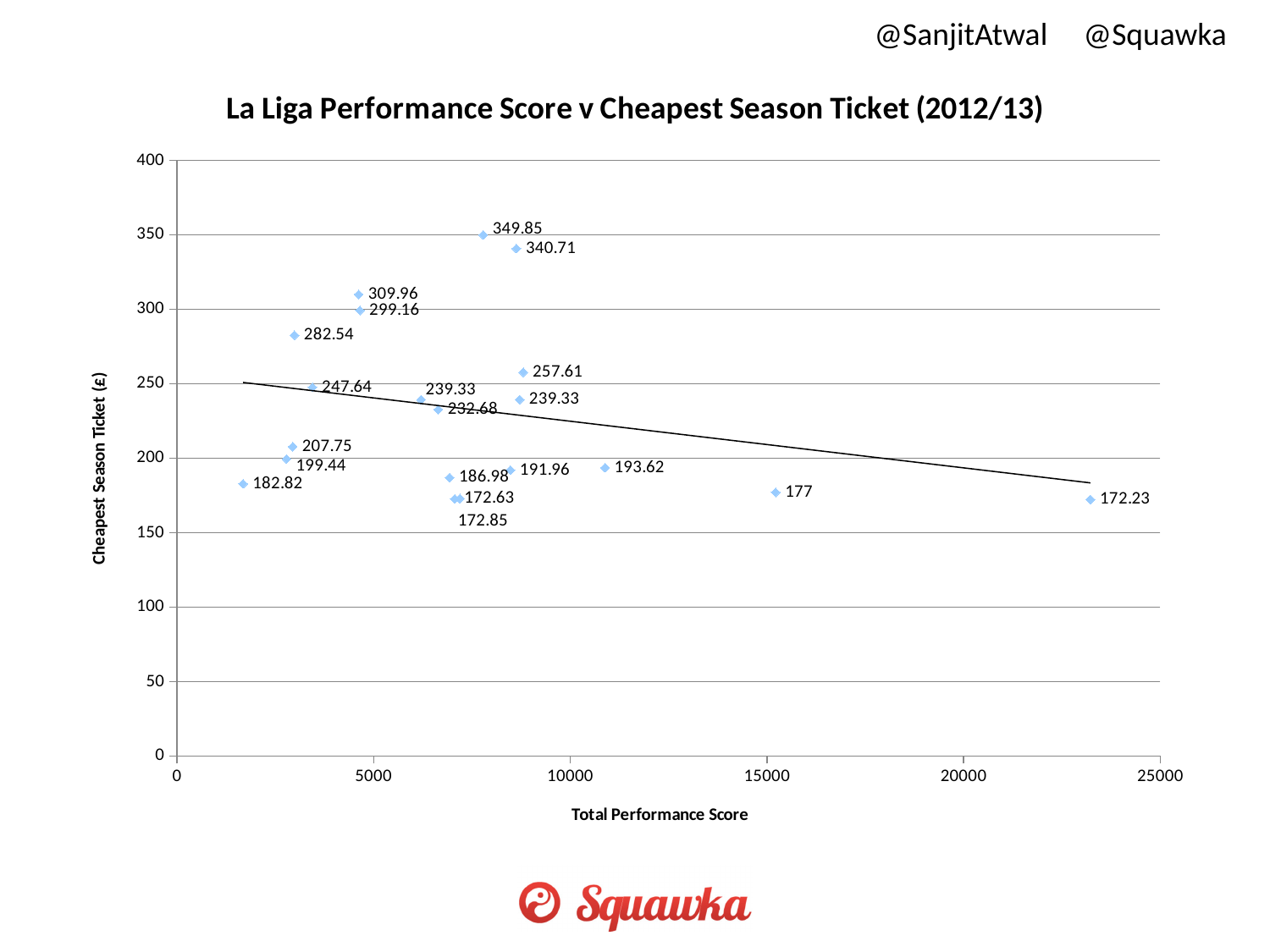
Does the trend line show the cheapest season ticket rising or falling as Total Performance Score increases? Falling What is the highest cheapest season ticket value labelled on the chart? 349.85 What kind of chart is shown on the slide? Scatter chart What is the lowest cheapest season ticket value labelled on the chart? 172.23 What is the label of the vertical axis? Cheapest Season Ticket (£) What is the cheapest season ticket value for the point plotted at a Total Performance Score of roughly 15000? 177 What is the cheapest season ticket value for the point with the highest Total Performance Score? 172.23 How many data points are plotted on the chart? 20 What is the difference between the highest and lowest labelled cheapest season ticket values? 177.62 How many points have a cheapest season ticket value above 300? 3 What is the cheapest season ticket value for the point with the lowest Total Performance Score? 182.82 What is the title of the chart? La Liga Performance Score v Cheapest Season Ticket (2012/13)